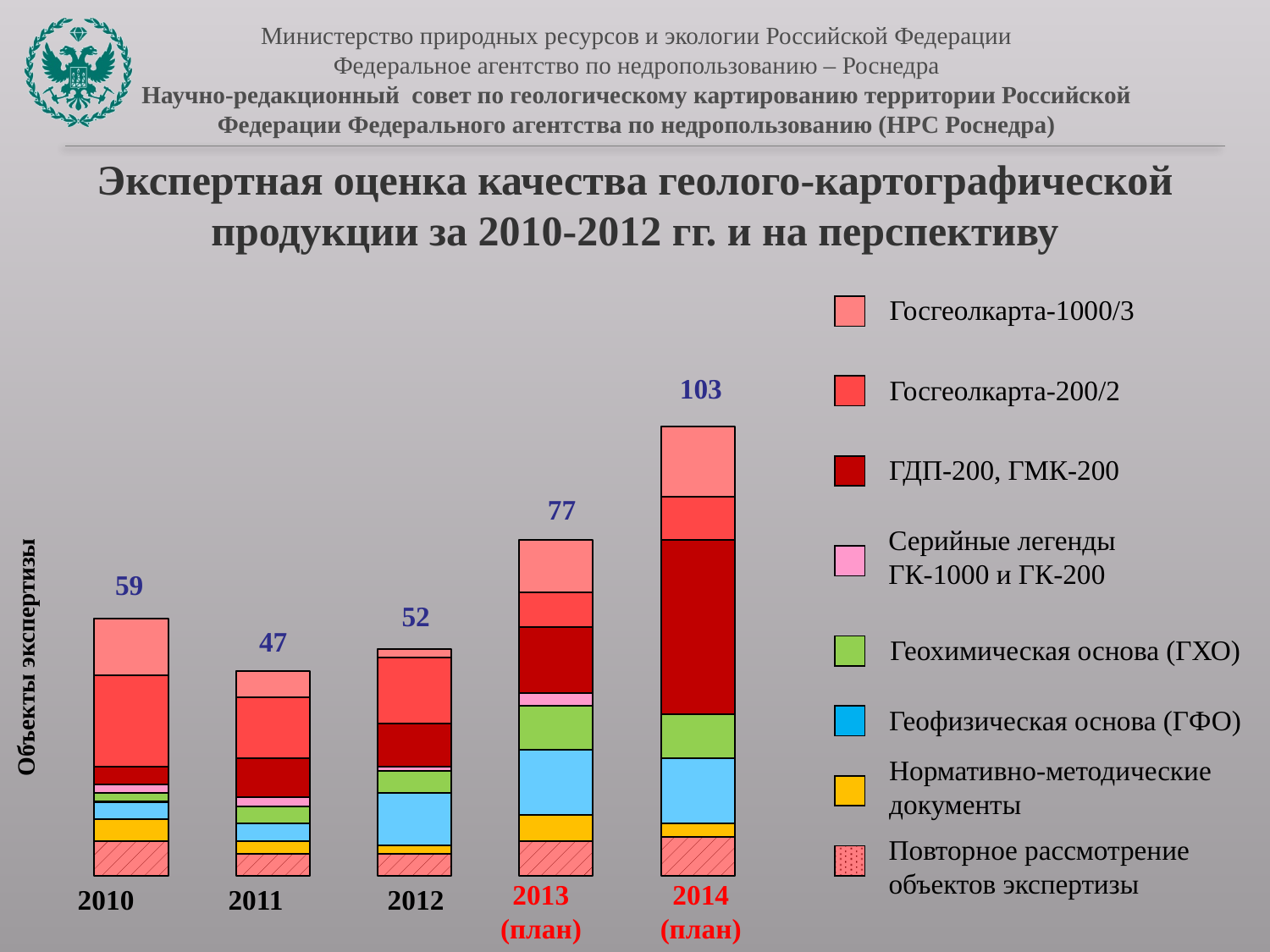
What is the difference between the totals for 2014 (план) and 2013 (план)? 26 What is the total value shown above the bar for 2012? 52 Which year has the highest total value? 2014 (план) How many years (bars) are shown on the chart? 5 Which year has the lowest total value? 2011 What kind of chart is shown on the slide? Stacked bar chart How many series does the legend list? 8 Do the bar totals rise or fall from 2011 to 2014 (план)? Rise What is the difference between the totals for 2010 and 2011? 12 What is the total value shown above the bar for 2014 (план)? 103 Which total is larger, 2010 or 2012? 2010 What is the total value shown above the bar for 2010? 59